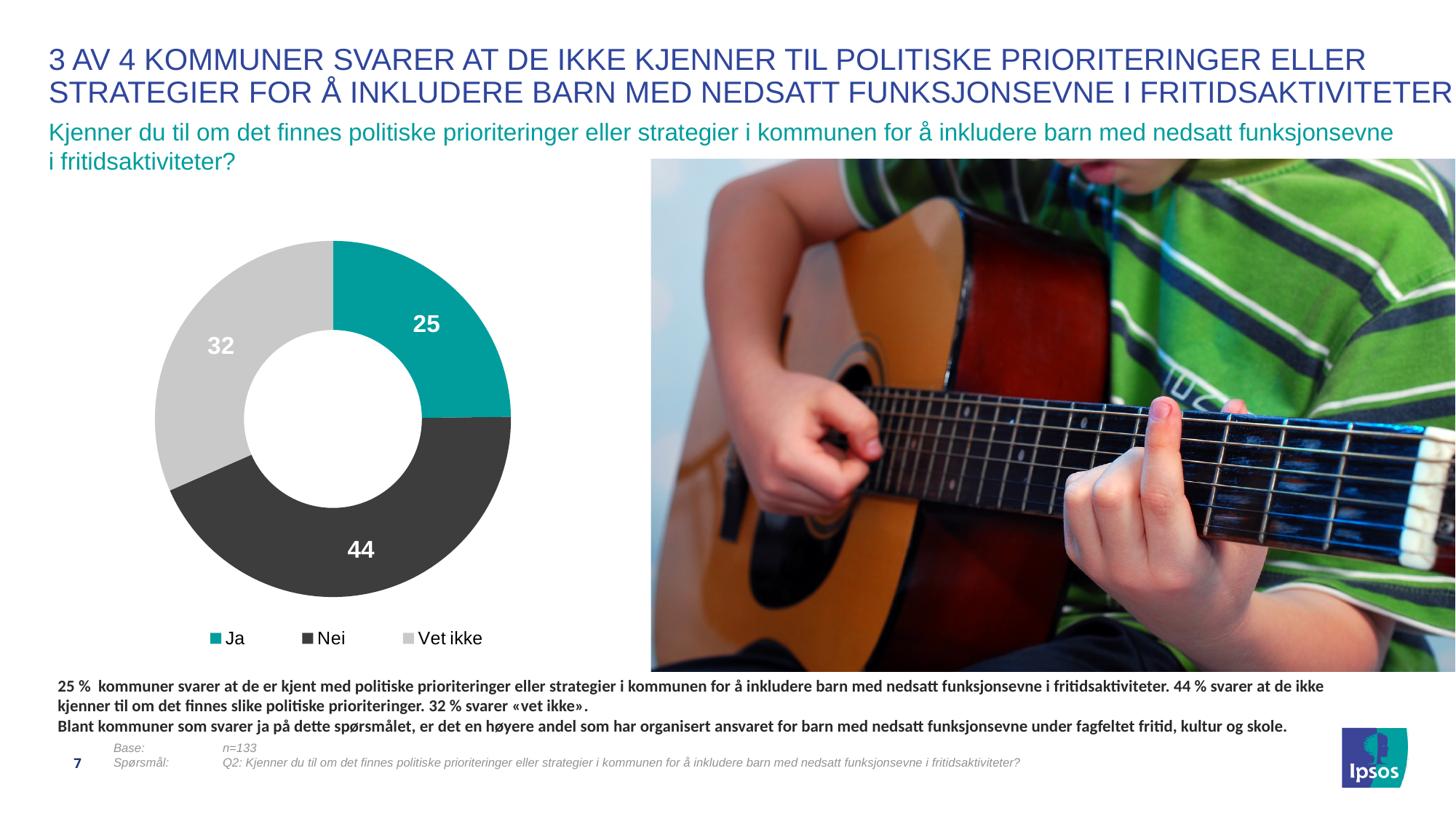
Which category has the smallest slice in the doughnut chart? Ja Which category has the largest slice in the doughnut chart? Nei What value is shown for the "Nei" slice of the doughnut chart? 44 What is the difference between the values for "Vet ikke" and "Ja" in the doughnut chart? 7 What value is shown for the "Vet ikke" slice of the doughnut chart? 32 What are the three legend entries of the doughnut chart? Ja, Nei, Vet ikke What colour is the "Ja" slice in the doughnut chart? Teal How many categories does the doughnut chart show? 3 Which is larger in the doughnut chart, the value for "Nei" or the value for "Vet ikke"? Nei What is the difference between the values for "Nei" and "Ja" in the doughnut chart? 19 What kind of chart is shown on the slide? Doughnut chart What value is shown for the "Ja" slice of the doughnut chart? 25